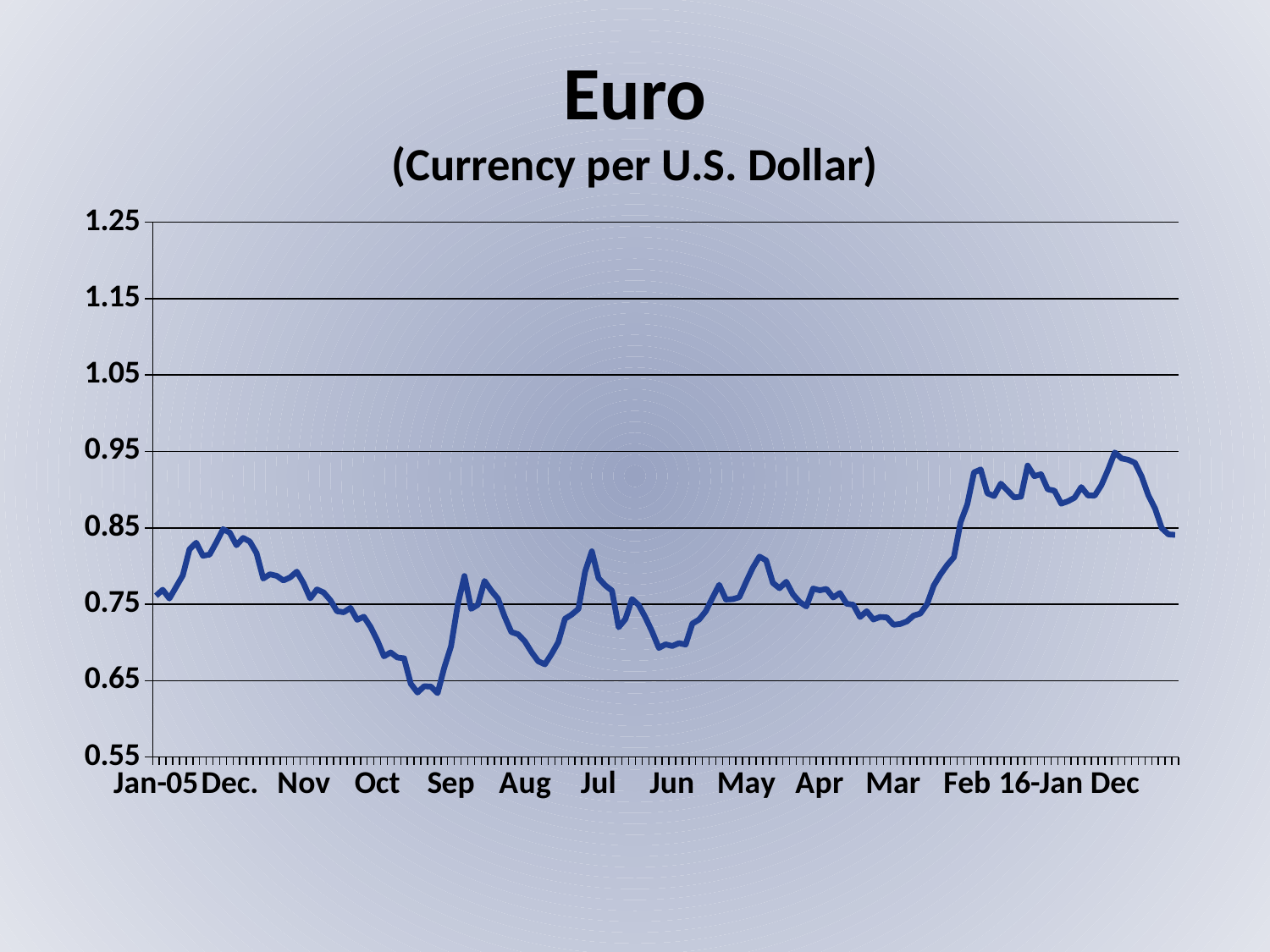
What is the highest value shown on the y axis? 1.25 How many lines are plotted on the chart? 1 How many labels are shown along the x axis of the chart? 14 Is the value at the Jun label greater or less than 0.75? less Is the value at the Mar label greater or less than 0.75? less Is the value at the Feb label greater or less than 0.85? greater What is the title of the chart? Euro (Currency per U.S. Dollar) Does the line rise or fall between the Mar label and the Feb label? rise Near which x-axis label does the line reach its highest value? Dec What kind of chart is shown on the slide? line chart